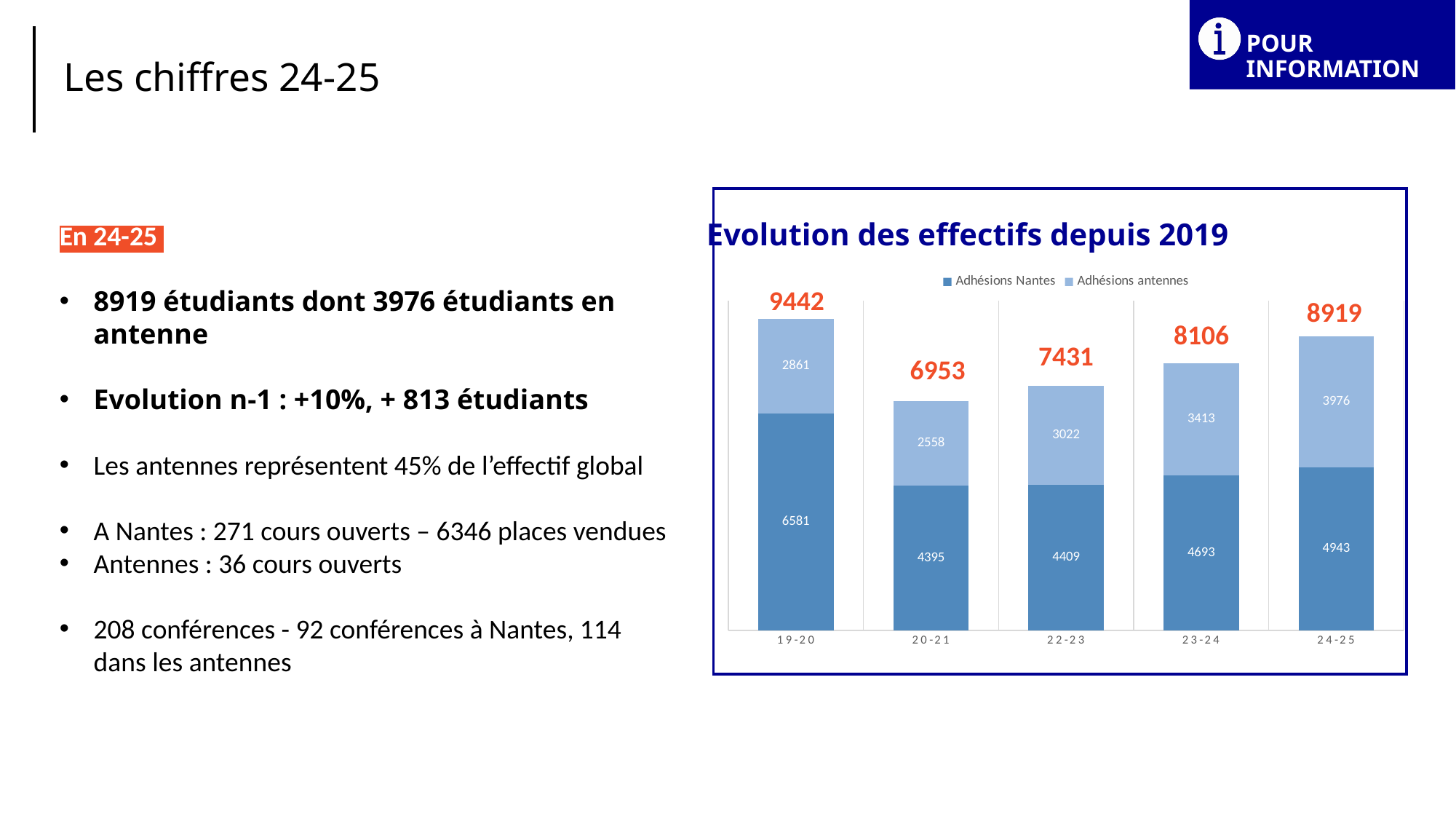
What is the value of Adhésions antennes for 22-23? 3022 Which is larger: Adhésions Nantes for 20-21 or Adhésions Nantes for 22-23? Adhésions Nantes for 22-23 What is the value of Adhésions antennes for 24-25? 3976 What is the total of the stacked bar for 23-24? 8106 How many series does the legend list? 2 What is the difference between the totals for 24-25 and 23-24? 813 What is the title of the chart? Evolution des effectifs depuis 2019 Which year has the lowest total? 20-21 What is the value of Adhésions Nantes for 19-20? 6581 How many years are shown on the x axis? 5 Which year has the highest total? 19-20 What kind of chart is shown? Stacked bar chart